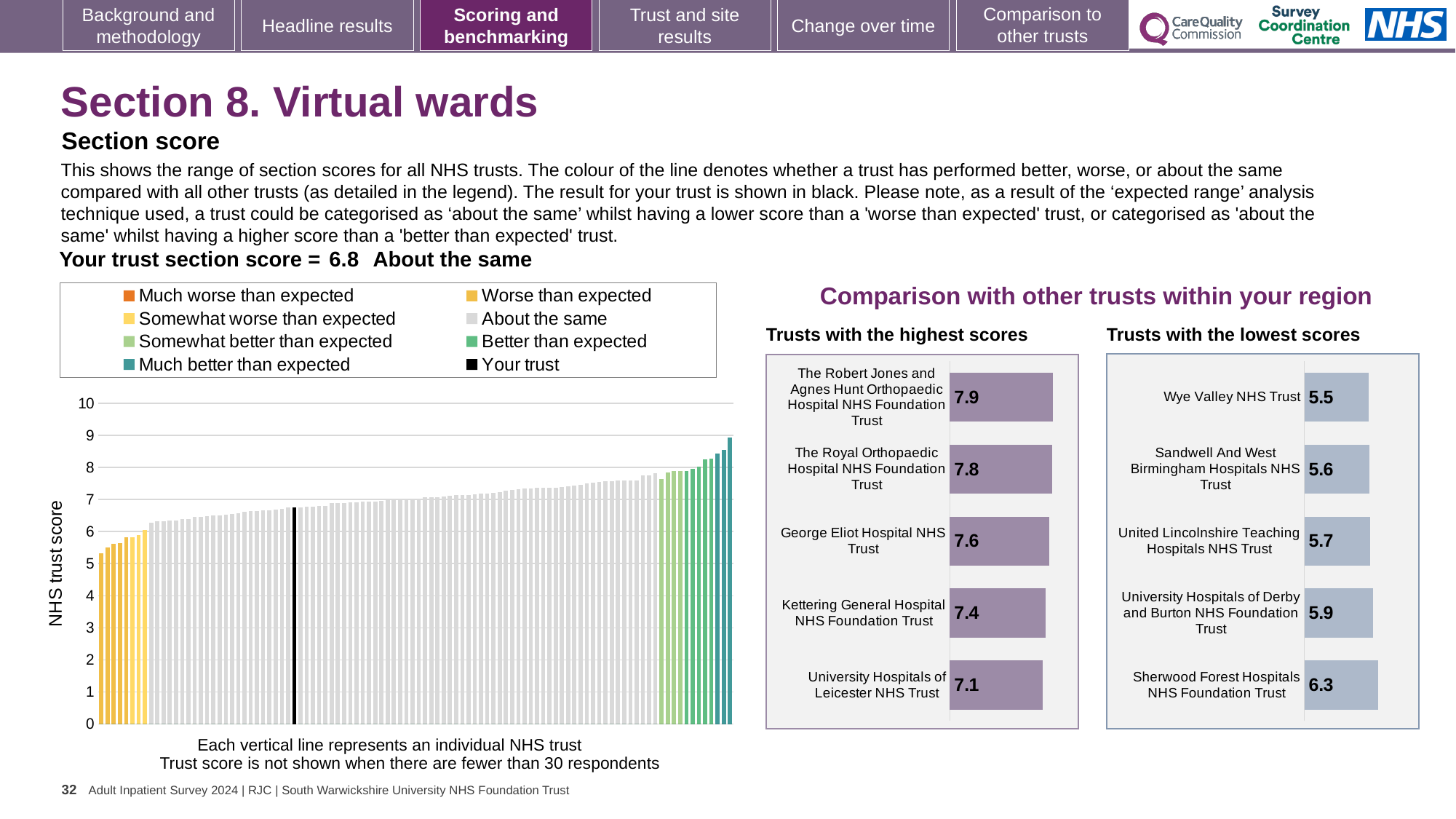
In the 'Trusts with the lowest scores' chart, what is the score for Sherwood Forest Hospitals NHS Foundation Trust? 6.3 How many entries does the legend of the large chart on the left list? 8 What kind of chart is the large chart on the left showing NHS trust scores? Bar chart In the large chart on the left showing NHS trust scores, do the values rise or fall from left to right? Rise In the 'Trusts with the lowest scores' chart, which trust has the lowest score? Wye Valley NHS Trust How many trusts are shown in the 'Trusts with the highest scores' chart? 5 In the large chart on the left, what is the section score for your trust (the black bar)? 6.8 In the 'Trusts with the lowest scores' chart, what is the difference between the scores of Sherwood Forest Hospitals NHS Foundation Trust and Wye Valley NHS Trust? 0.8 In the 'Trusts with the lowest scores' chart, which has the higher score: Sandwell And West Birmingham Hospitals NHS Trust or United Lincolnshire Teaching Hospitals NHS Trust? United Lincolnshire Teaching Hospitals NHS Trust In the 'Trusts with the highest scores' chart, what is the score for George Eliot Hospital NHS Trust? 7.6 In the 'Trusts with the highest scores' chart, which trust has the highest score? The Robert Jones and Agnes Hunt Orthopaedic Hospital NHS Foundation Trust In the 'Trusts with the highest scores' chart, what is the difference between the scores of The Robert Jones and Agnes Hunt Orthopaedic Hospital NHS Foundation Trust and University Hospitals of Leicester NHS Trust? 0.8